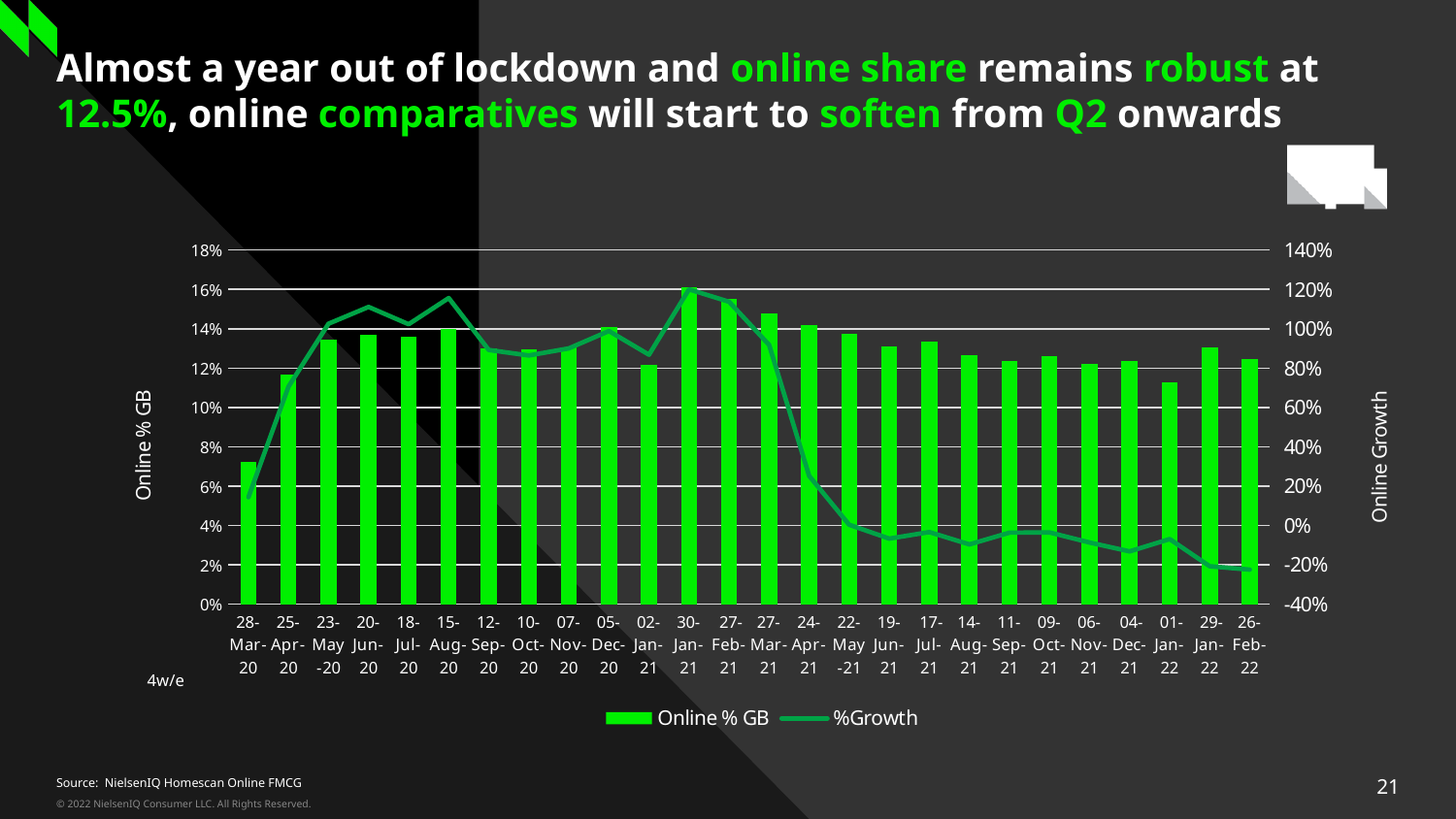
Which has the higher Online % GB bar, 25-Apr-20 or 23-May-20? 23-May-20 What are the two series named in the legend? Online % GB and %Growth How many 4-week periods are plotted along the x axis? 26 Which period has the shortest Online % GB bar? 28-Mar-20 What kind of chart is shown on the slide? A combined bar and line chart Which period has the tallest Online % GB bar? 30-Jan-21 Does the %Growth line rise or fall between 27-Mar-21 and 22-May-21? Fall Is the Online % GB value for 01-Jan-22 greater or less than 12%? less How many series does the chart legend list? 2 What is the title of the left vertical axis? Online % GB Is the Online % GB value for 30-Jan-21 greater or less than 14%? greater Is the Online % GB value for 28-Mar-20 greater or less than 8%? less